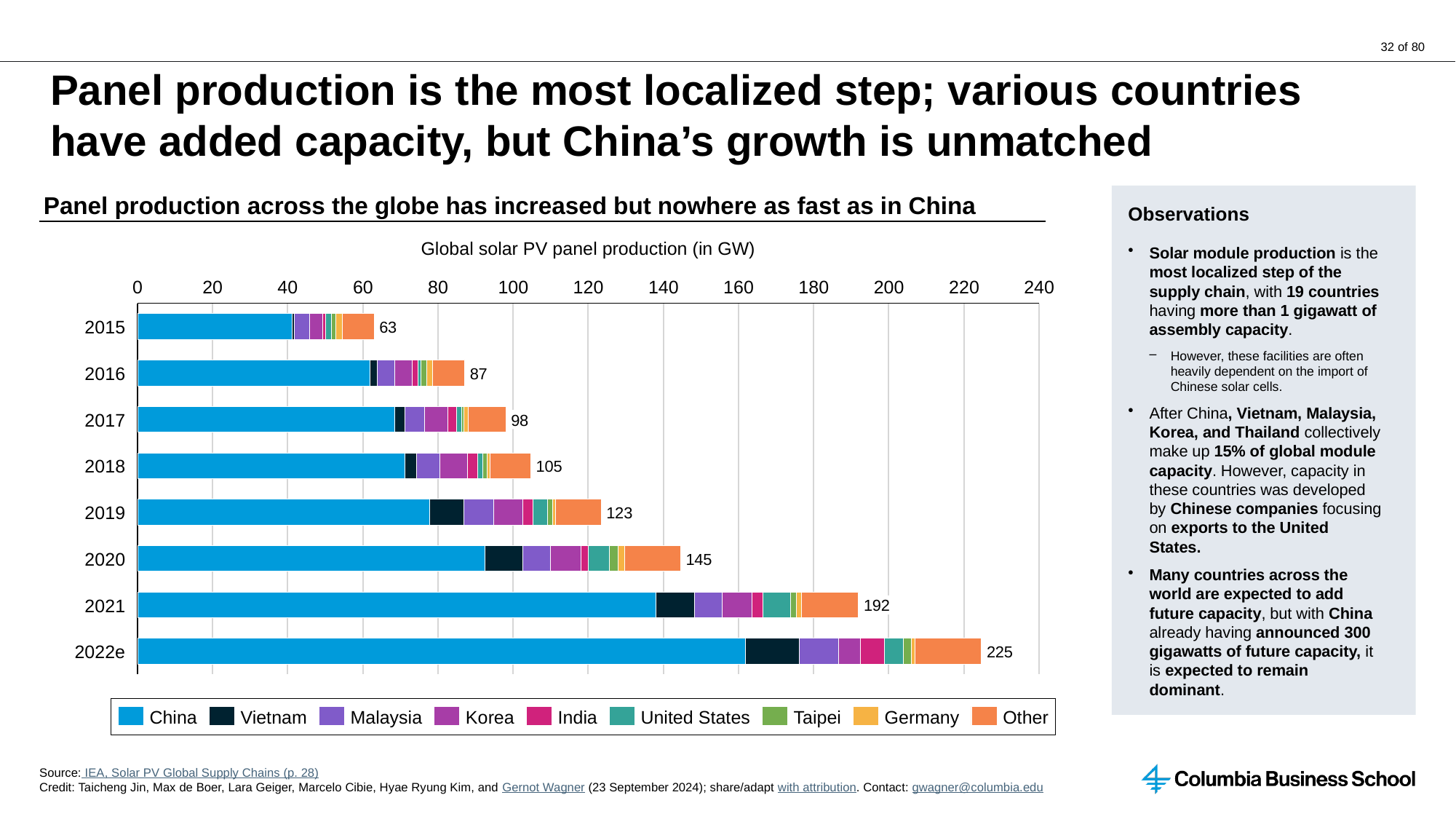
Which year has the lowest total panel production in the chart? 2015 Which year has a larger total panel production, 2018 or 2017? 2018 What is the difference between the total panel production in 2022e and in 2021? 33 How many series does the legend list? 9 How many years are shown on the chart? 8 What is the total global solar PV panel production shown for 2022e? 225 What kind of chart is used to show global solar PV panel production? Stacked bar chart Is China's panel production in 2022e greater or less than 140 GW? greater What is the total global solar PV panel production shown for 2015? 63 What is the difference between the total panel production in 2020 and in 2019? 22 Which year has the highest total panel production in the chart? 2022e What is the total global solar PV panel production shown for 2021? 192